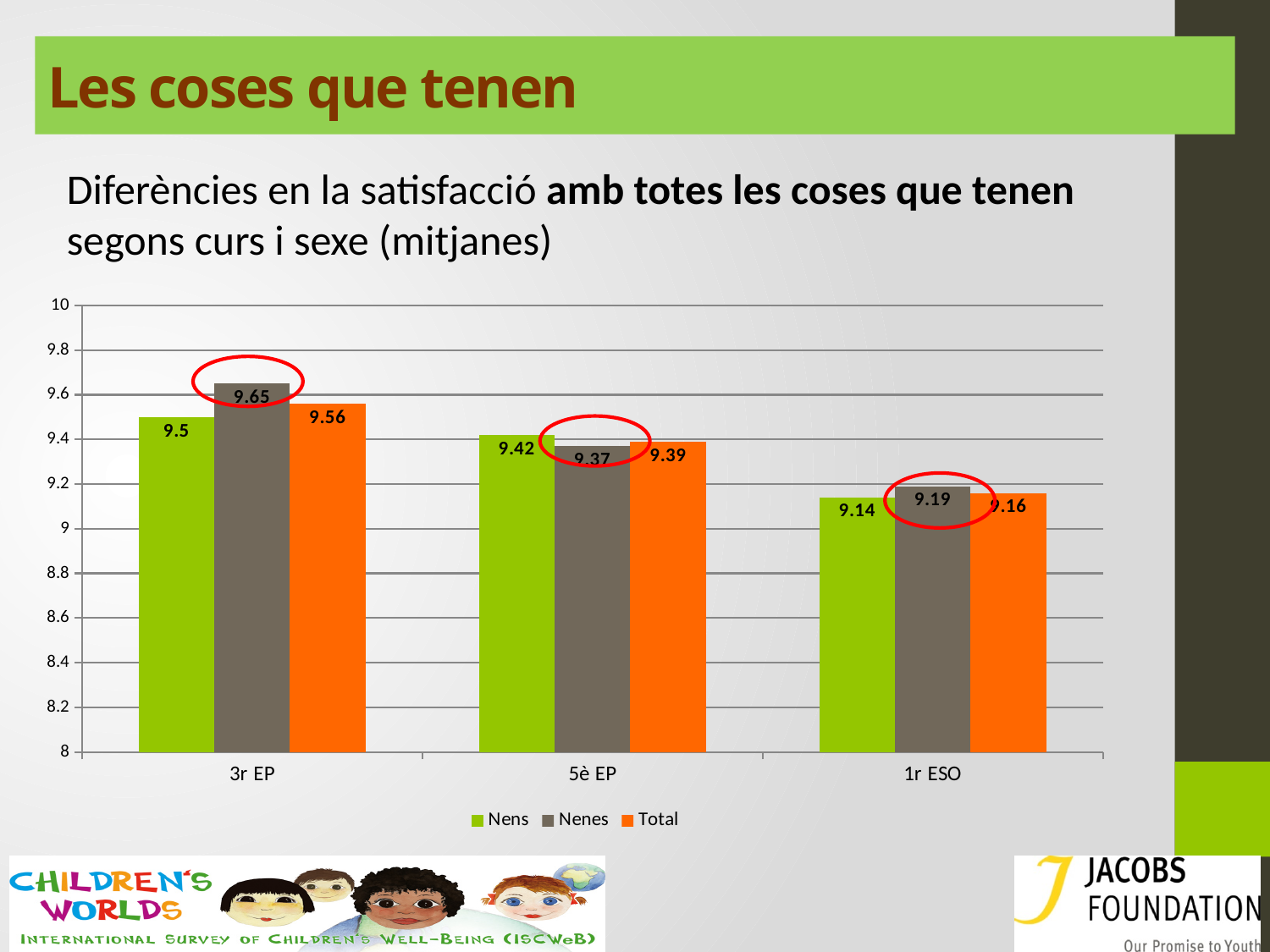
What is the value for Nens in 3r EP? 9.5 What is the difference between the Nenes and Nens values in 3r EP? 0.15 Which category has the highest Nenes value? 3r EP What is the Total value for 5è EP? 9.39 How many series does the legend list? 3 What is the value for Nenes in 1r ESO? 9.19 What kind of chart is shown on the slide? Bar chart Which category has the lowest Nens value? 1r ESO How many categories are shown on the x axis? 3 Which is larger in 5è EP, the Nens value or the Nenes value? Nens What is the value for Nenes in 3r EP? 9.65 Do the Total values rise or fall from 3r EP to 1r ESO? Fall